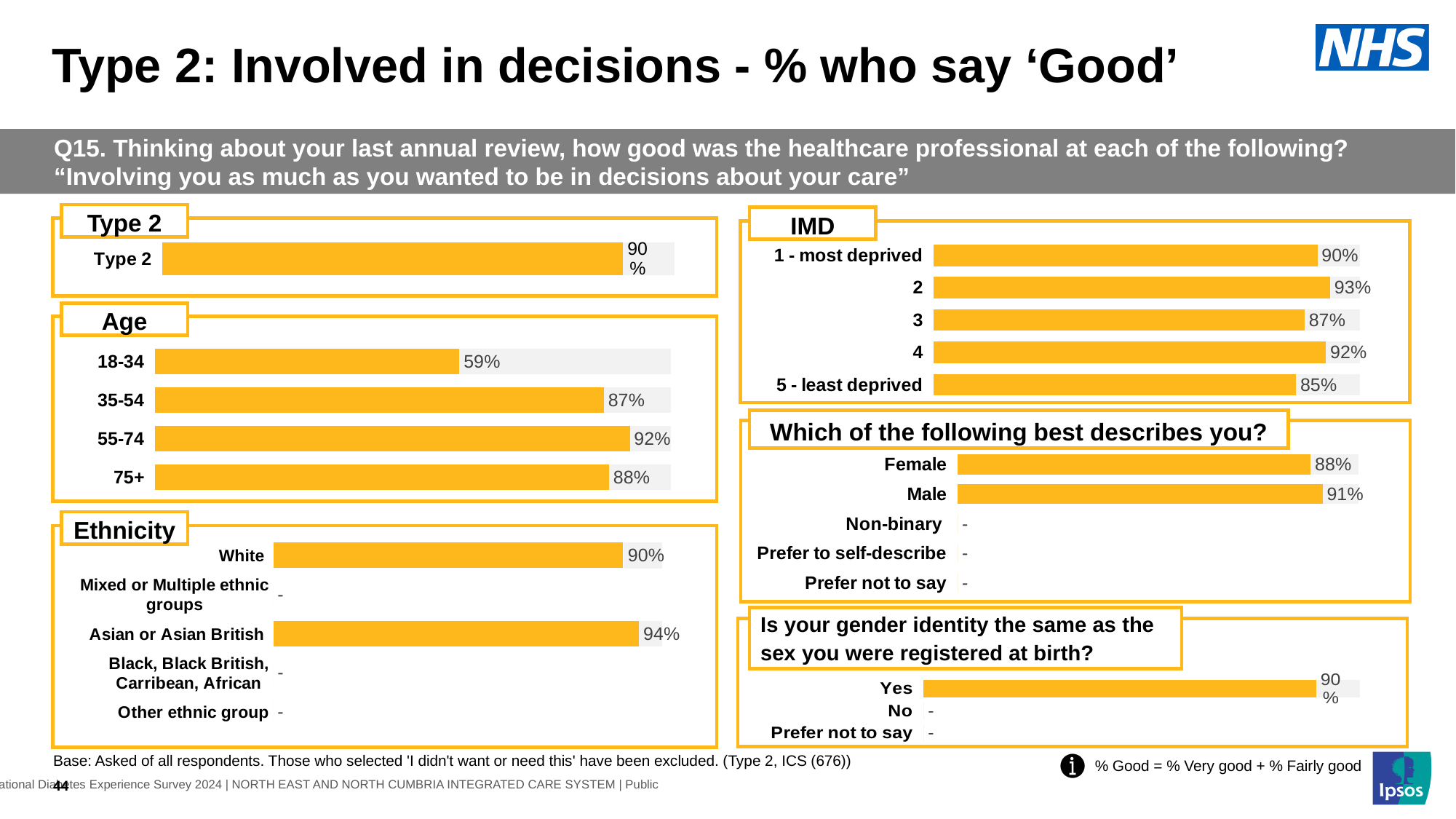
In the IMD chart, which category has the lowest value? 5 - least deprived In the IMD chart, what is the value for '2'? 93% What type of chart is used in the Age section? Bar chart In the Age chart, which age group has the highest value? 55-74 In the IMD chart, how many categories are plotted? 5 In the IMD chart, which is larger: the value for '1 - most deprived' or '3'? 1 - most deprived In the Ethnicity chart, what is the value for Asian or Asian British? 94% In the 'Is your gender identity the same as the sex you were registered at birth?' chart, what is the value for Yes? 90% In the 'Which of the following best describes you?' chart, what is the difference between the values for Male and Female? 3 percentage points In the Age chart, which age group has the lowest value? 18-34 In the Age chart, what is the difference between the values for 55-74 and 18-34? 33 percentage points In the Age chart, what is the value for the 18-34 group? 59%